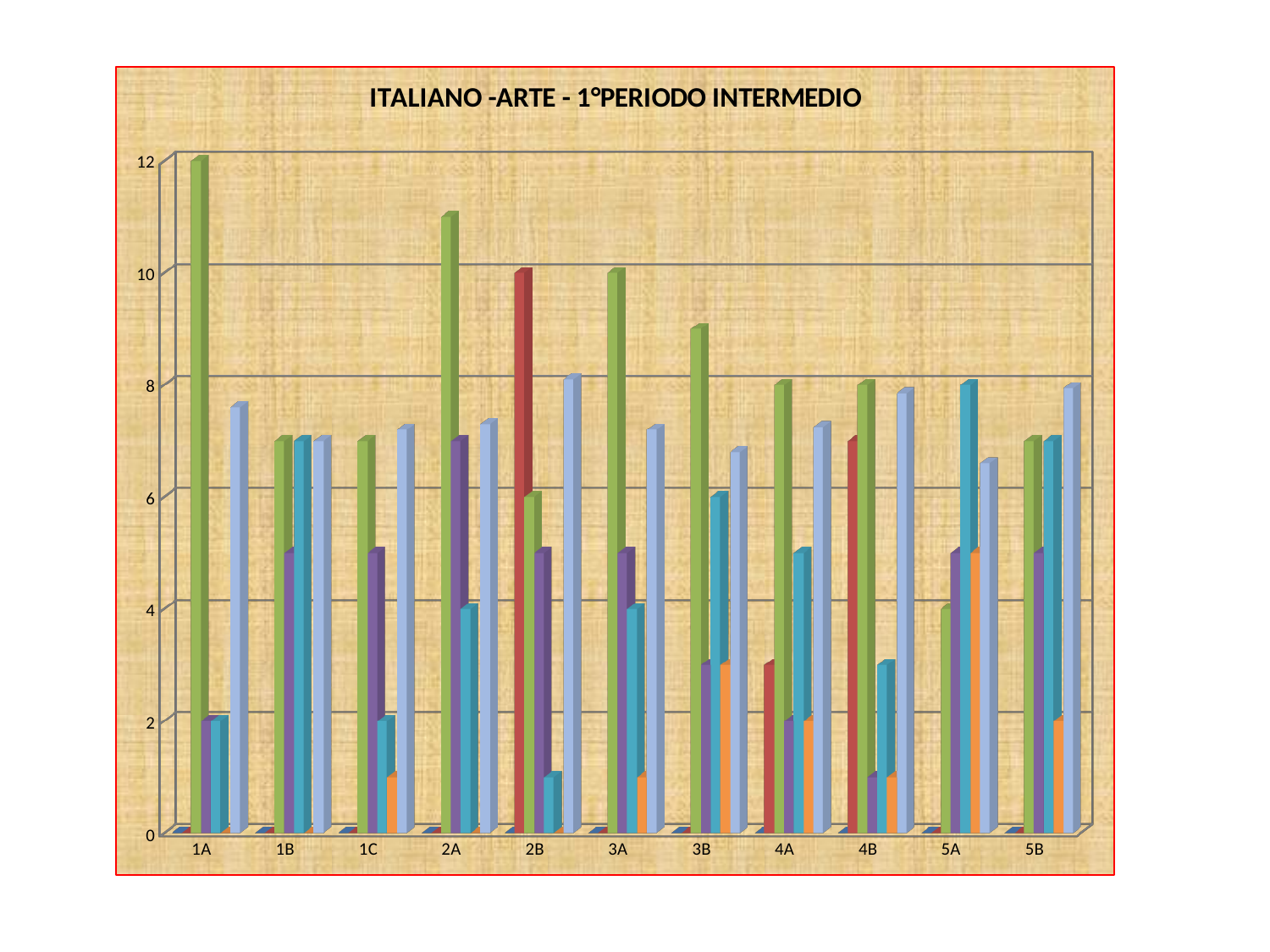
Is the tallest bar for category 1B greater or less than 8? less Is the tallest bar for category 4B greater or less than 6? greater What is the highest value shown on the vertical axis of the chart? 12 Which category contains the tallest bar in the chart? 1A What kind of chart is shown on the slide? bar chart Which category has the taller tallest bar, 2B or 5B? 2B How many categories are shown on the x axis of the chart? 11 Which category has the taller tallest bar, 1A or 3A? 1A Is the tallest bar for category 5A greater or less than 10? less What is the title of the chart? ITALIANO -ARTE - 1°PERIODO INTERMEDIO